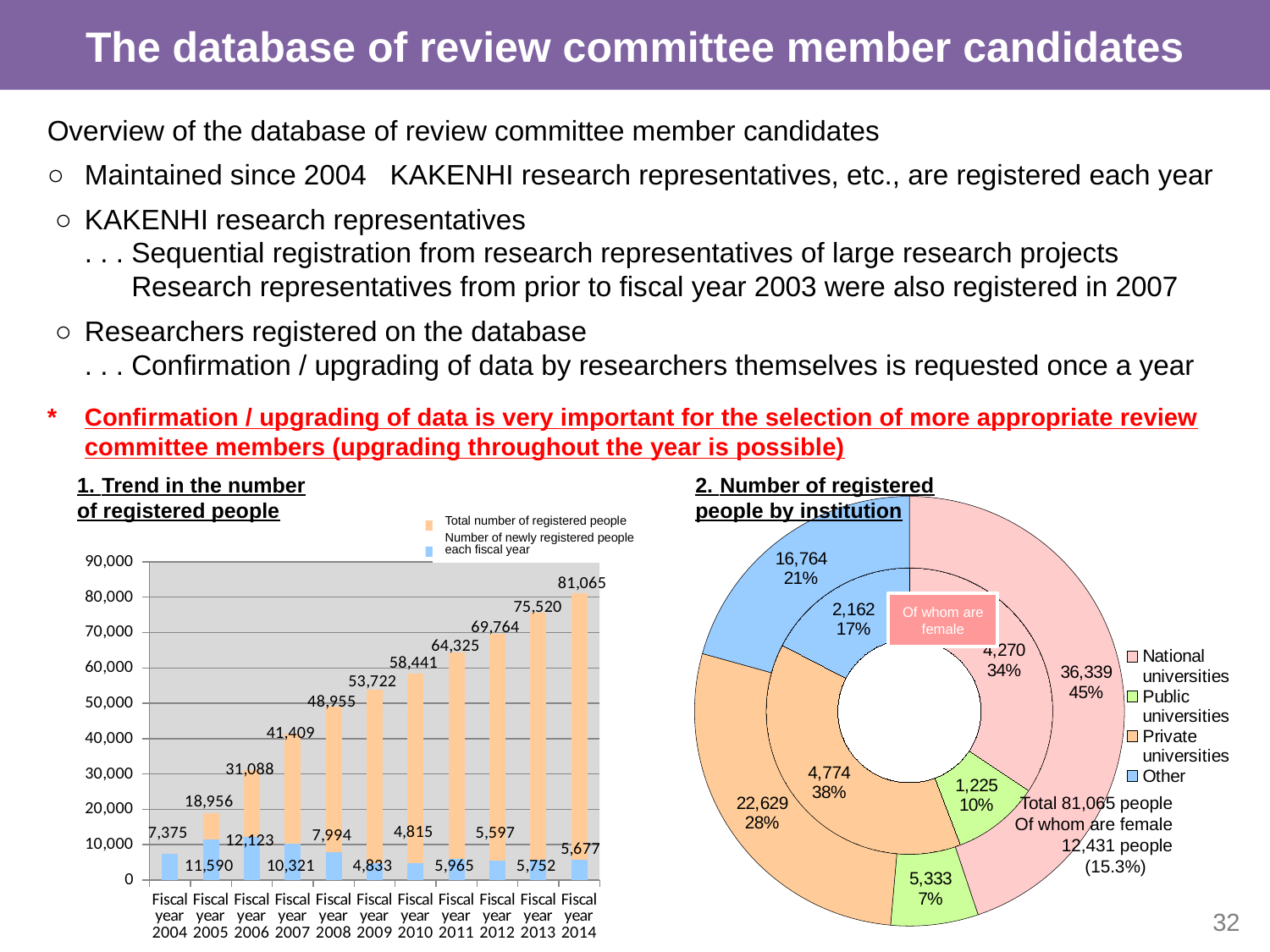
In the chart '2. Number of registered people by institution', what share of registered people are from Private universities? 28% In the chart '1. Trend in the number of registered people', does the total number of registered people rise or fall from fiscal year 2004 to fiscal year 2014? Rise In the chart '1. Trend in the number of registered people', how many fiscal years are shown on the x axis? 11 In the chart '1. Trend in the number of registered people', how many series does the legend list? 2 In the chart '1. Trend in the number of registered people', which fiscal year from 2005 onward has the highest number of newly registered people? Fiscal year 2006 In the chart '1. Trend in the number of registered people', how many people were newly registered in fiscal year 2006? 12,123 In the chart '2. Number of registered people by institution', which institution type has the fewest registered people? Public universities In the chart '1. Trend in the number of registered people', by how much did the total number of registered people increase from fiscal year 2013 to fiscal year 2014? 5,545 In the chart '1. Trend in the number of registered people', what kind of chart is used? Bar chart In the chart '2. Number of registered people by institution', how many of the registered people in the 'Other' category are female? 2,162 In the chart '2. Number of registered people by institution', how many registered people are from National universities? 36,339 In the chart '1. Trend in the number of registered people', what is the total number of registered people in fiscal year 2014? 81,065